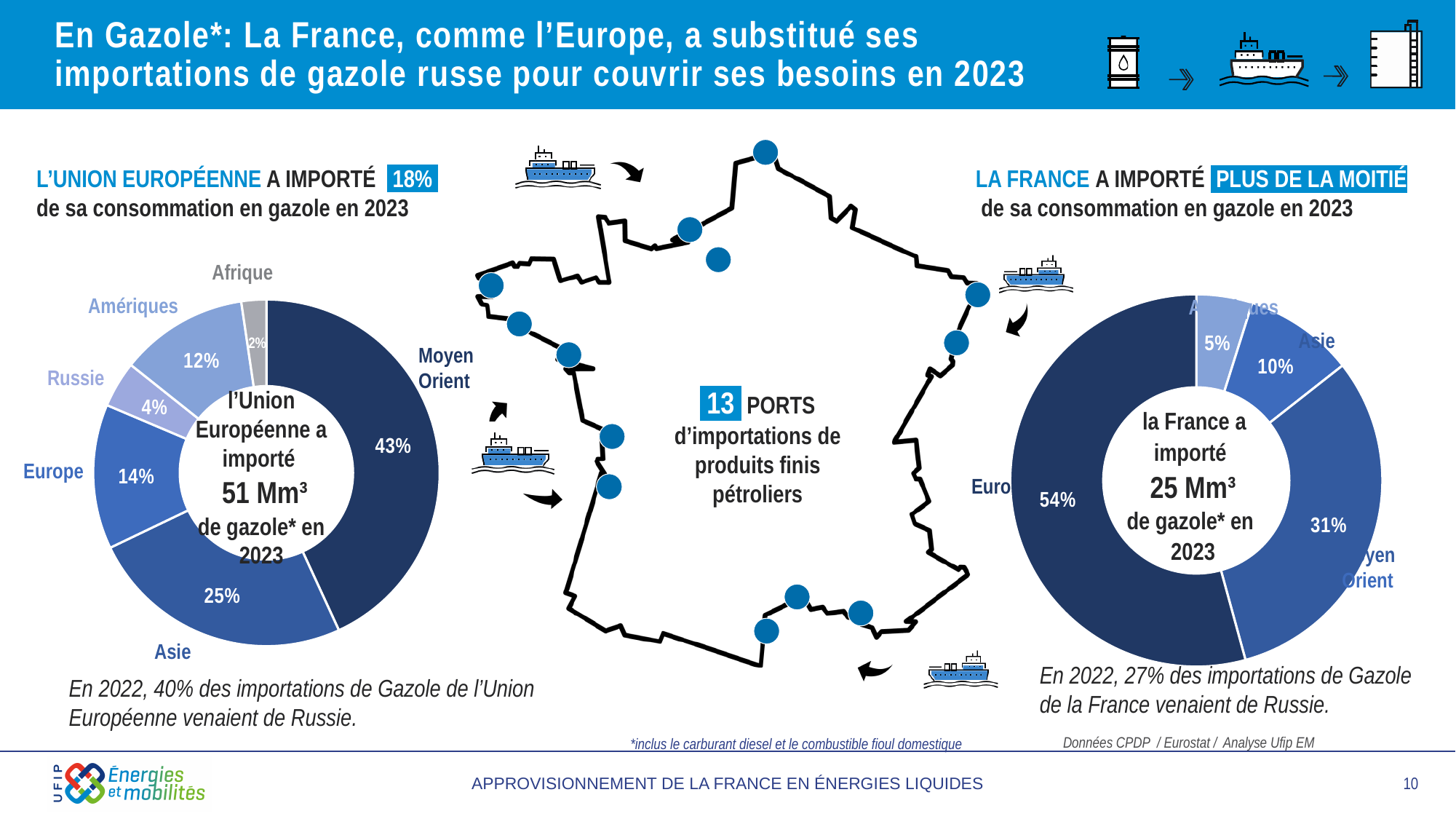
According to the centre text of the right donut chart, how much gasoil did France import in 2023? 25 Mm³ On the right donut chart (France), what is the largest share shown? 54% On the left donut chart (European Union), which share is larger, Amériques or Russie? Amériques On the left donut chart (European Union), what share of gasoil imports came from Russie? 4% On the left donut chart (European Union), which region has the largest share? Moyen Orient On the right donut chart (France), what share of gasoil imports came from Asie? 10% On the left donut chart (European Union), which region has the smallest share? Afrique How many regions are shown on the left donut chart (European Union)? 6 On the left donut chart (European Union), what share of gasoil imports came from Asie? 25% On the left donut chart (European Union), what share of gasoil imports came from Moyen Orient? 43% What type of chart is used on the left side of the slide for the European Union? Pie (donut) chart On the left donut chart (European Union), what is the difference between the shares of Asie and Europe? 11%